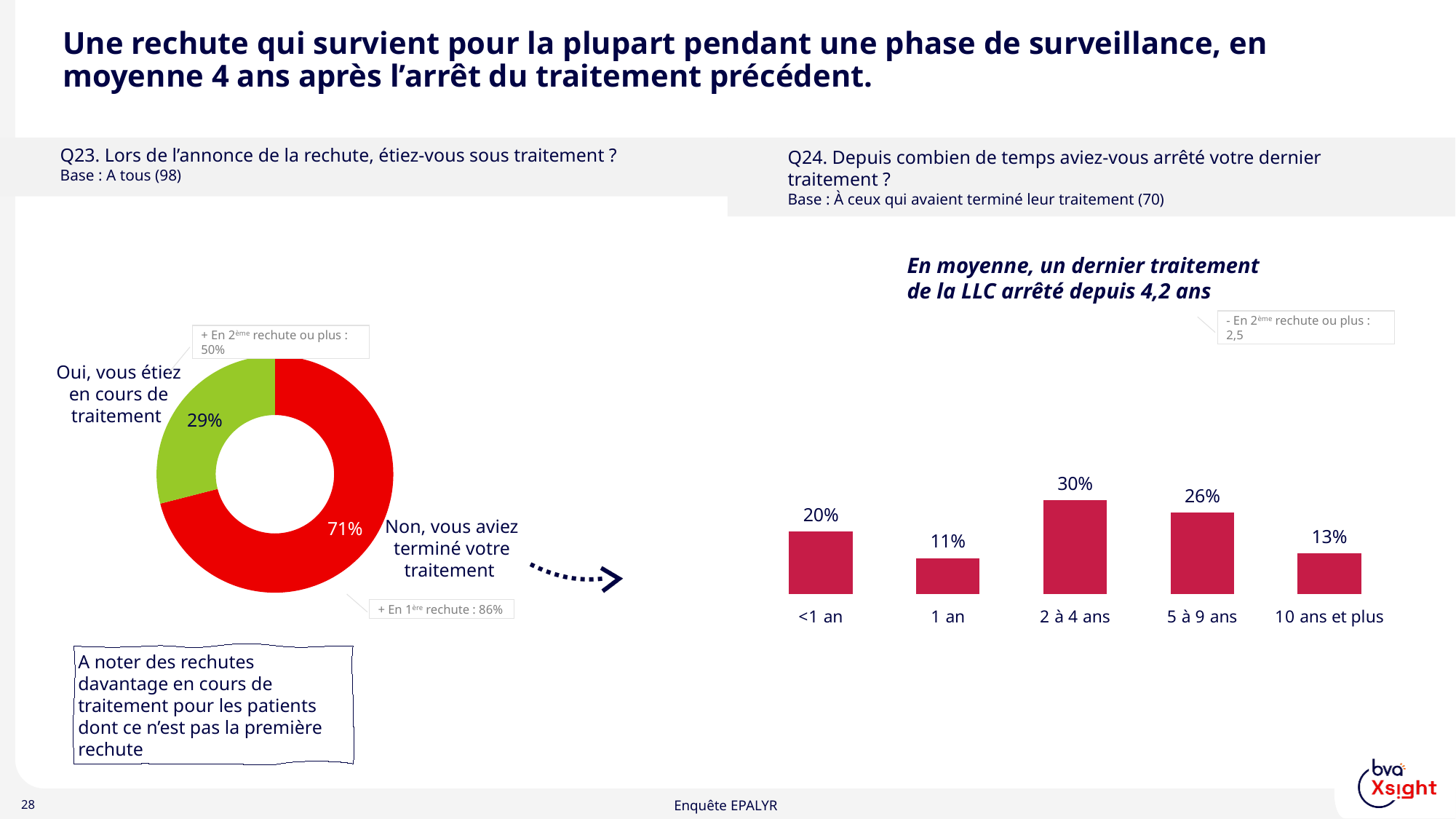
In the Q24 bar chart on the right, how many categories are shown? 5 In the Q24 bar chart on the right, which category has the highest value? 2 à 4 ans In the Q23 donut chart on the left, what kind of chart is used? Donut (pie) chart In the Q23 donut chart on the left, which colour represents 'Oui, vous étiez en cours de traitement'? Green In the Q24 bar chart on the right, what is the difference between '5 à 9 ans' and '10 ans et plus'? 13 percentage points In the Q23 donut chart on the left, what percentage of respondents answered 'Non, vous aviez terminé votre traitement'? 71% In the Q24 bar chart on the right, which is larger: the value for '<1 an' or the value for '1 an'? <1 an In the Q24 bar chart on the right, what is the value for '2 à 4 ans'? 30% In the Q24 bar chart on the right, which category has the lowest value? 1 an In the Q24 bar chart on the right, what is the value for '<1 an'? 20% In the Q23 donut chart on the left, what percentage of respondents answered 'Oui, vous étiez en cours de traitement'? 29% In the Q23 donut chart on the left, what is the difference between the 'Non' share and the 'Oui' share? 42 percentage points